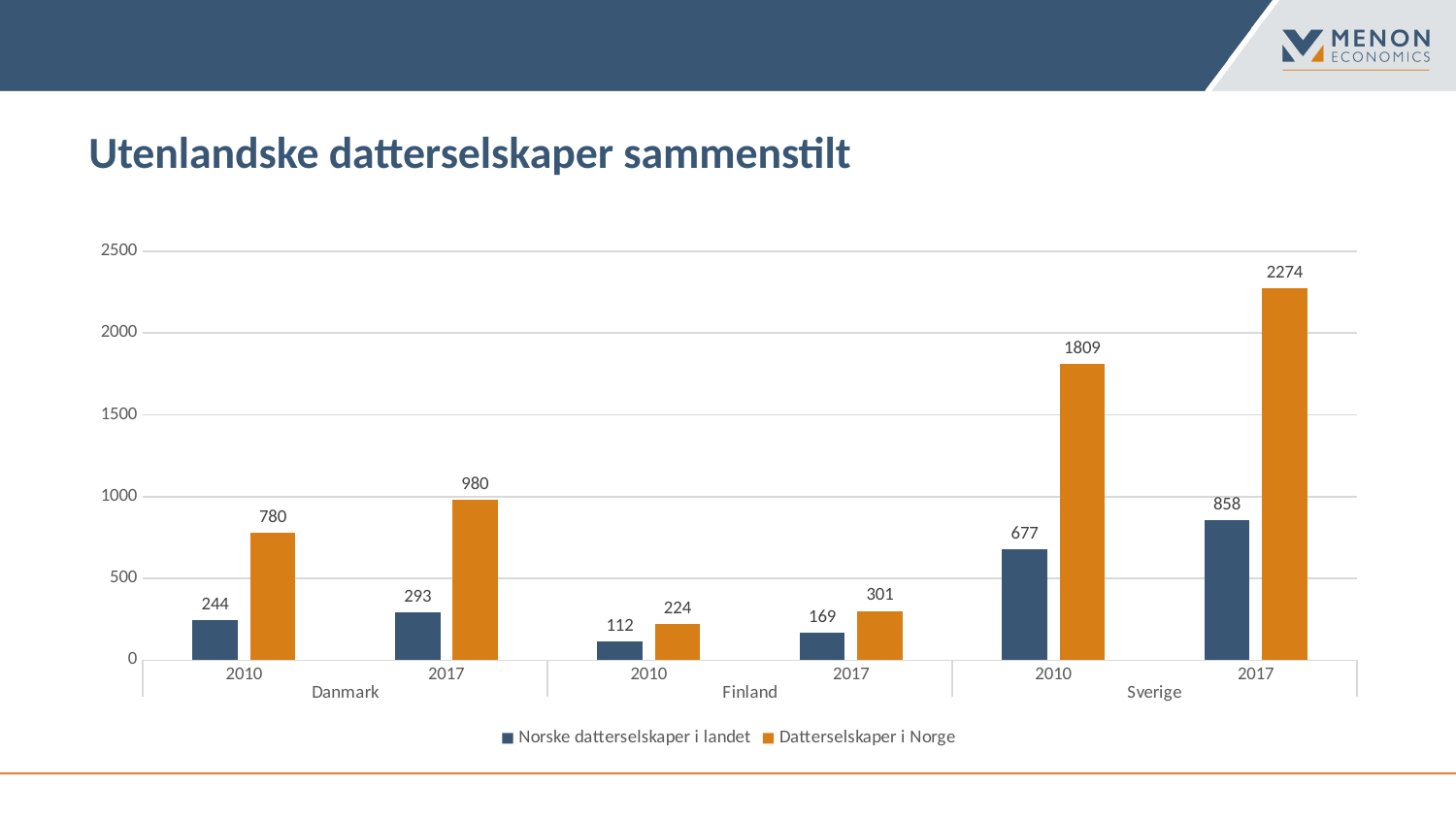
Does the value of Datterselskaper i Norge for Danmark rise or fall from 2010 to 2017? Rise What is the value of Norske datterselskaper i landet for Danmark in 2010? 244 What is the value of Datterselskaper i Norge for Finland in 2010? 224 How many series does the legend list? 2 What is the title of the chart on the slide? Utenlandske datterselskaper sammenstilt What is the value of Datterselskaper i Norge for Sverige in 2017? 2274 What is the value of Norske datterselskaper i landet for Sverige in 2017? 858 Which is larger: Norske datterselskaper i landet for Danmark in 2017 or for Finland in 2017? Danmark 2017 Which country and year has the lowest value for Norske datterselskaper i landet? Finland 2010 What kind of chart is shown on the slide? Bar chart What is the difference between Datterselskaper i Norge for Sverige in 2017 and in 2010? 465 Which country and year has the highest value for Datterselskaper i Norge? Sverige 2017